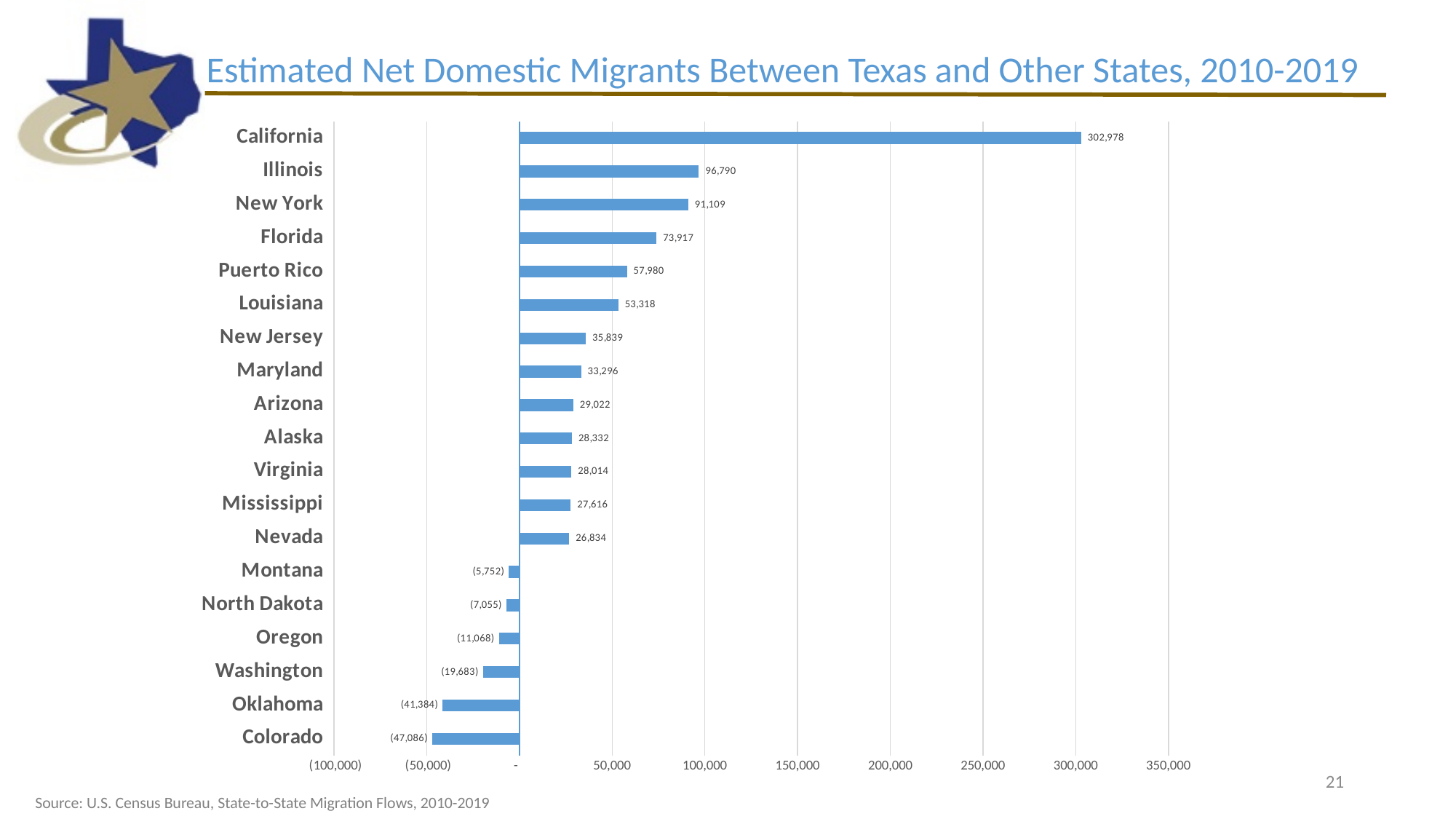
Is the value for New Jersey greater or less than 50,000? less What is the difference between the values for Illinois and New York? 5,681 What is the title of the chart? Estimated Net Domestic Migrants Between Texas and Other States, 2010-2019 What is the value shown for Colorado? (47,086) Which has a larger value, Florida or Puerto Rico? Florida Which state has the lowest (most negative) value on the chart? Colorado What kind of chart is shown on the slide? bar chart How many states or territories are shown on the chart? 19 What is the value shown for Louisiana? 53,318 What is the estimated net domestic migration value for California? 302,978 How many categories on the chart have negative values? 6 Which state has the highest net domestic migration to Texas? California